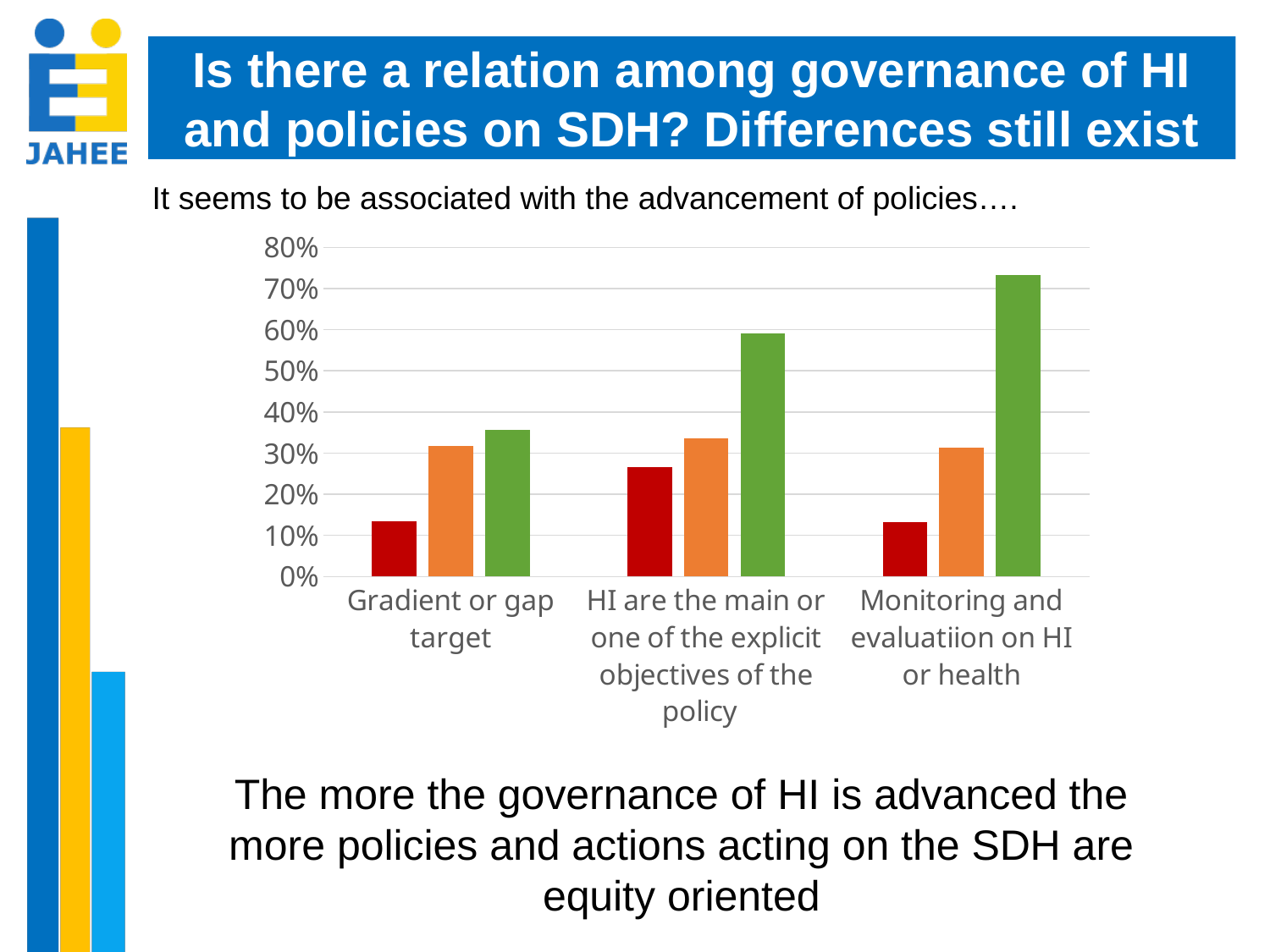
What kind of chart is shown on the slide? bar chart Is the red bar for "Monitoring and evaluatiion on HI or health" greater or less than 20%? less Which category has the tallest red bar? HI are the main or one of the explicit objectives of the policy What is the highest value shown on the y axis of the chart? 80% Which category has the tallest green bar? Monitoring and evaluatiion on HI or health Is the green bar for "Monitoring and evaluatiion on HI or health" greater or less than 60%? greater Is the green bar for "HI are the main or one of the explicit objectives of the policy" greater or less than 50%? greater How many categories are shown on the x axis of the chart? 3 Do the green bars rise or fall moving from left to right across the categories? rise In the "HI are the main or one of the explicit objectives of the policy" category, which is larger, the green bar or the red bar? green bar